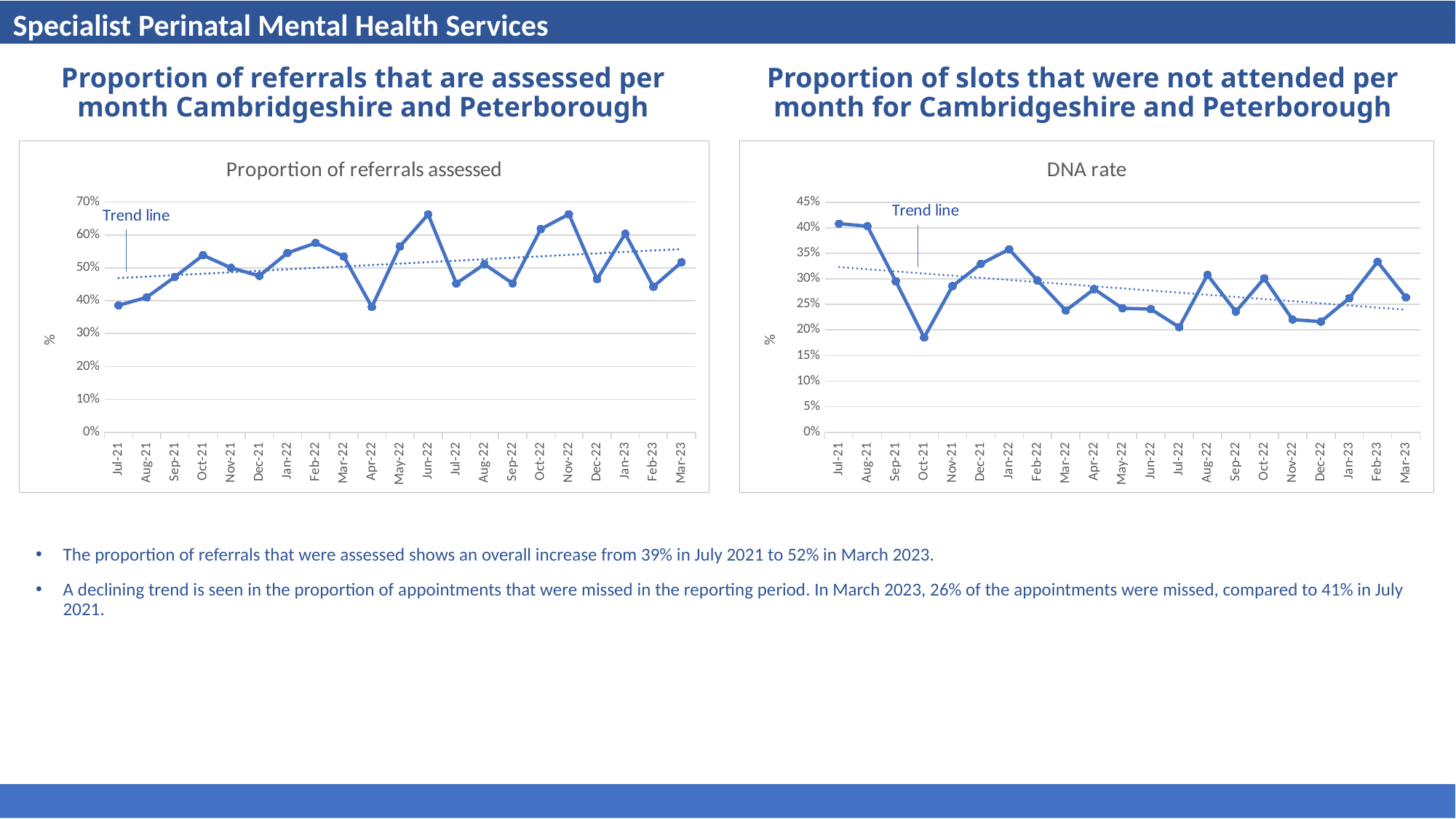
On the 'DNA rate' chart, which month has the lowest value? Oct-21 On the 'Proportion of referrals assessed' chart, which is larger, the value for Oct-22 or the value for Apr-22? Oct-22 On the 'DNA rate' chart, does the trend line rise or fall from Jul-21 to Mar-23? Falls On the 'Proportion of referrals assessed' chart, what was the value for March 2023? 52% How many monthly data points are plotted on the 'DNA rate' chart on the right? 21 On the 'Proportion of referrals assessed' chart, is the value for Jun-22 greater or less than 60%? greater What kind of chart is the 'Proportion of referrals assessed' chart on the left? Line chart On the 'DNA rate' chart, is the value for Oct-21 greater or less than 20%? less What is the label on the vertical axis of the 'Proportion of referrals assessed' chart? % On the 'DNA rate' chart, what was the value for March 2023? 26% On the 'Proportion of referrals assessed' chart, what was the value for July 2021? 39% On the 'DNA rate' chart, what is the difference between the July 2021 value and the March 2023 value? 15 percentage points